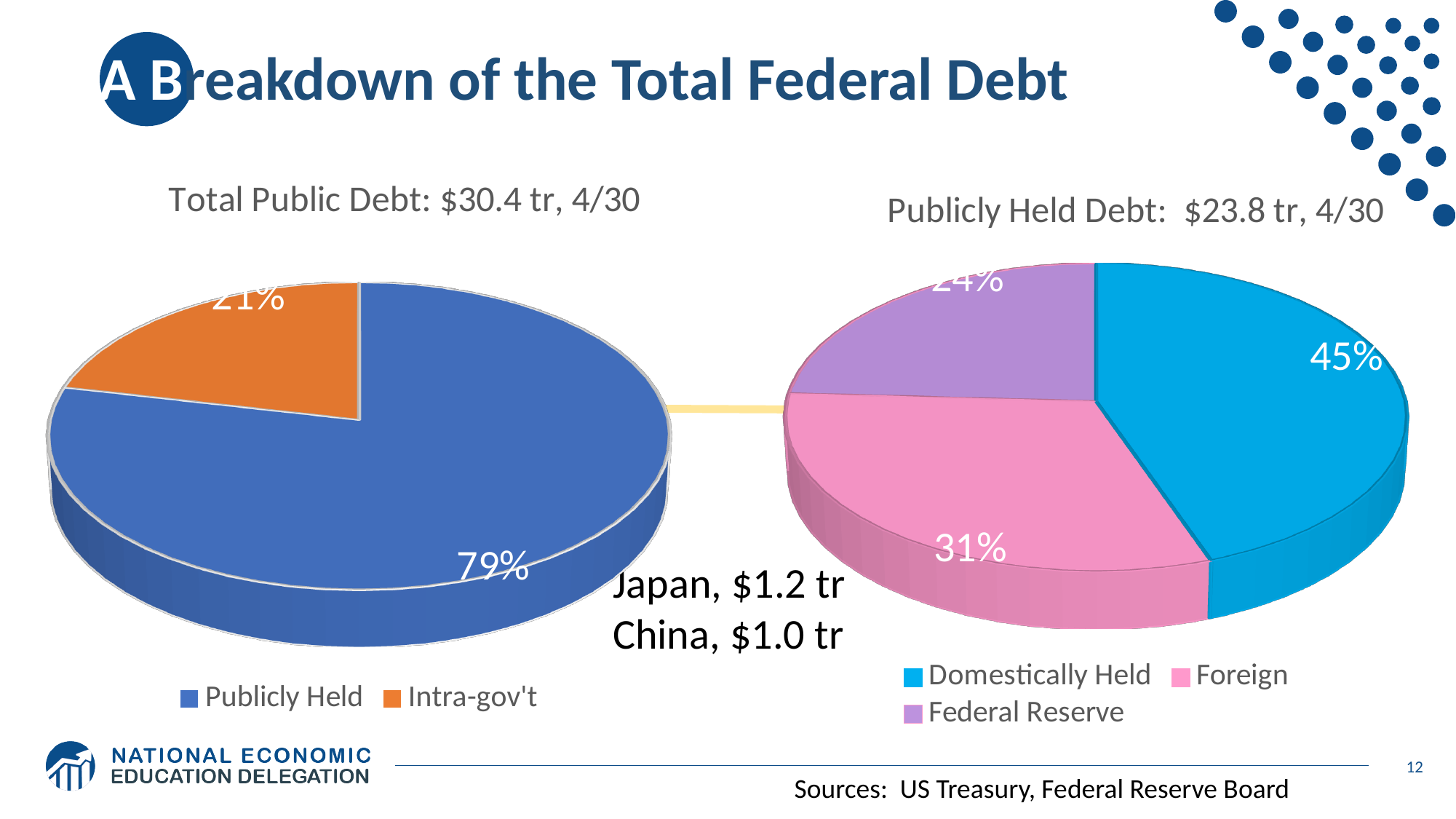
In the 'Publicly Held Debt' chart, what share is Domestically Held? 45% In the 'Publicly Held Debt' chart, what is the difference in percentage points between Domestically Held and Foreign? 14 How many entries does the legend of the 'Publicly Held Debt' chart list? 3 In the 'Total Public Debt' chart, which slice is the largest? Publicly Held In the 'Total Public Debt' chart, what share is Publicly Held? 79% In the 'Publicly Held Debt' chart, what share is Foreign? 31% What kind of chart is the 'Total Public Debt' chart on the left? pie chart In the 'Publicly Held Debt' chart, which is larger: Domestically Held or Foreign? Domestically Held In the 'Publicly Held Debt' chart, which slice is the smallest? Federal Reserve How many slices does the 'Total Public Debt' chart have? 2 What colour is the Foreign slice in the 'Publicly Held Debt' chart? pink